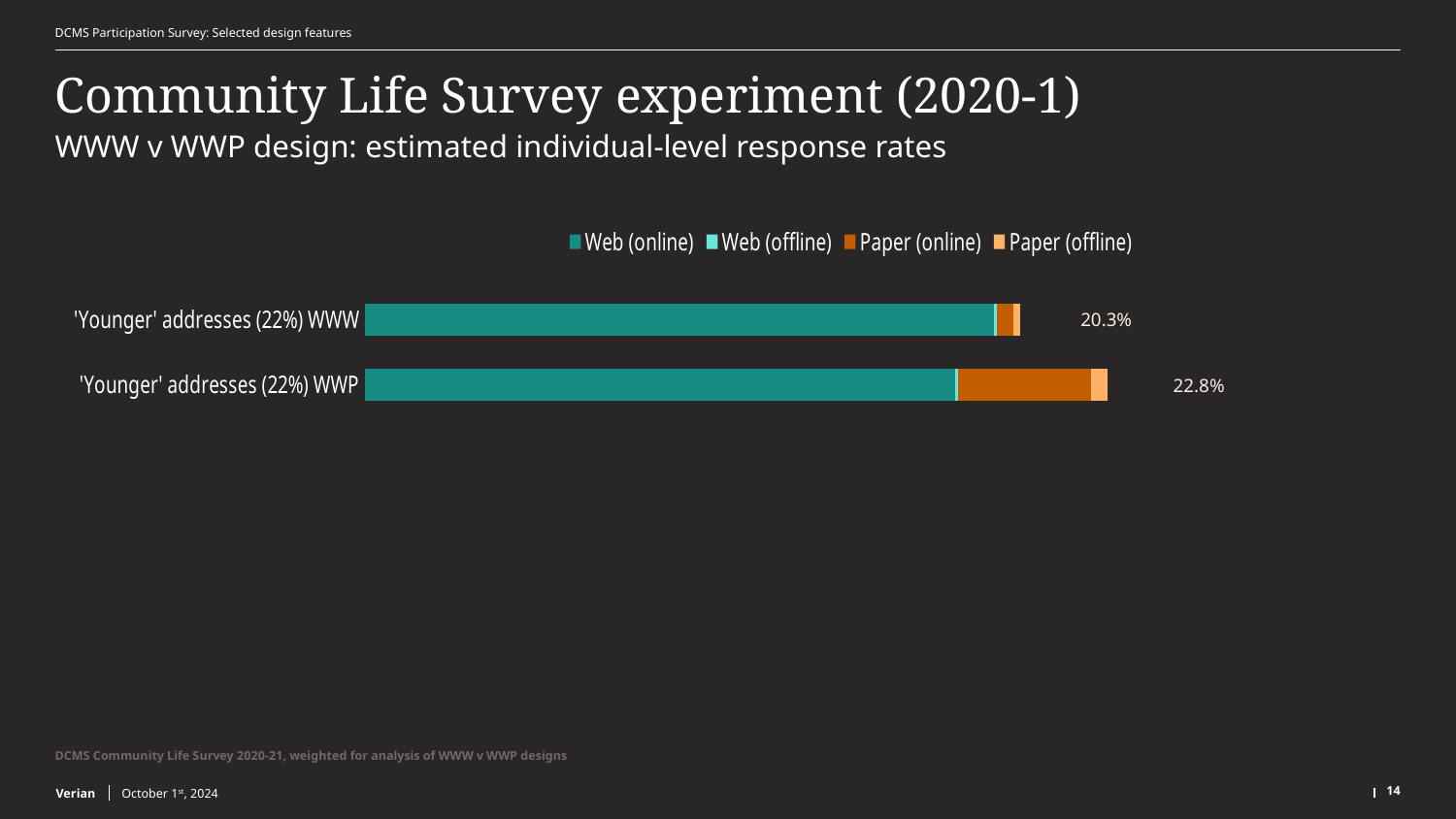
Which bar has the larger Paper (online) segment, WWW or WWP? WWP How many series does the legend list? 4 Which series is shown in the legend immediately after Web (offline)? Paper (online) Which series makes up the largest segment of each bar? Web (online) Is the total response rate for the WWW design larger or smaller than that for the WWP design? smaller What kind of chart is shown on the slide? Stacked bar chart How many bars are plotted in the chart? 2 Which design has the lower total response rate, WWW or WWP? WWW What is the total response rate shown for 'Younger' addresses (22%) WWW? 20.3% Which design has the higher total response rate, WWW or WWP? WWP What is the total response rate shown for 'Younger' addresses (22%) WWP? 22.8% What is the difference between the total response rates for the WWP and WWW designs? 2.5 percentage points